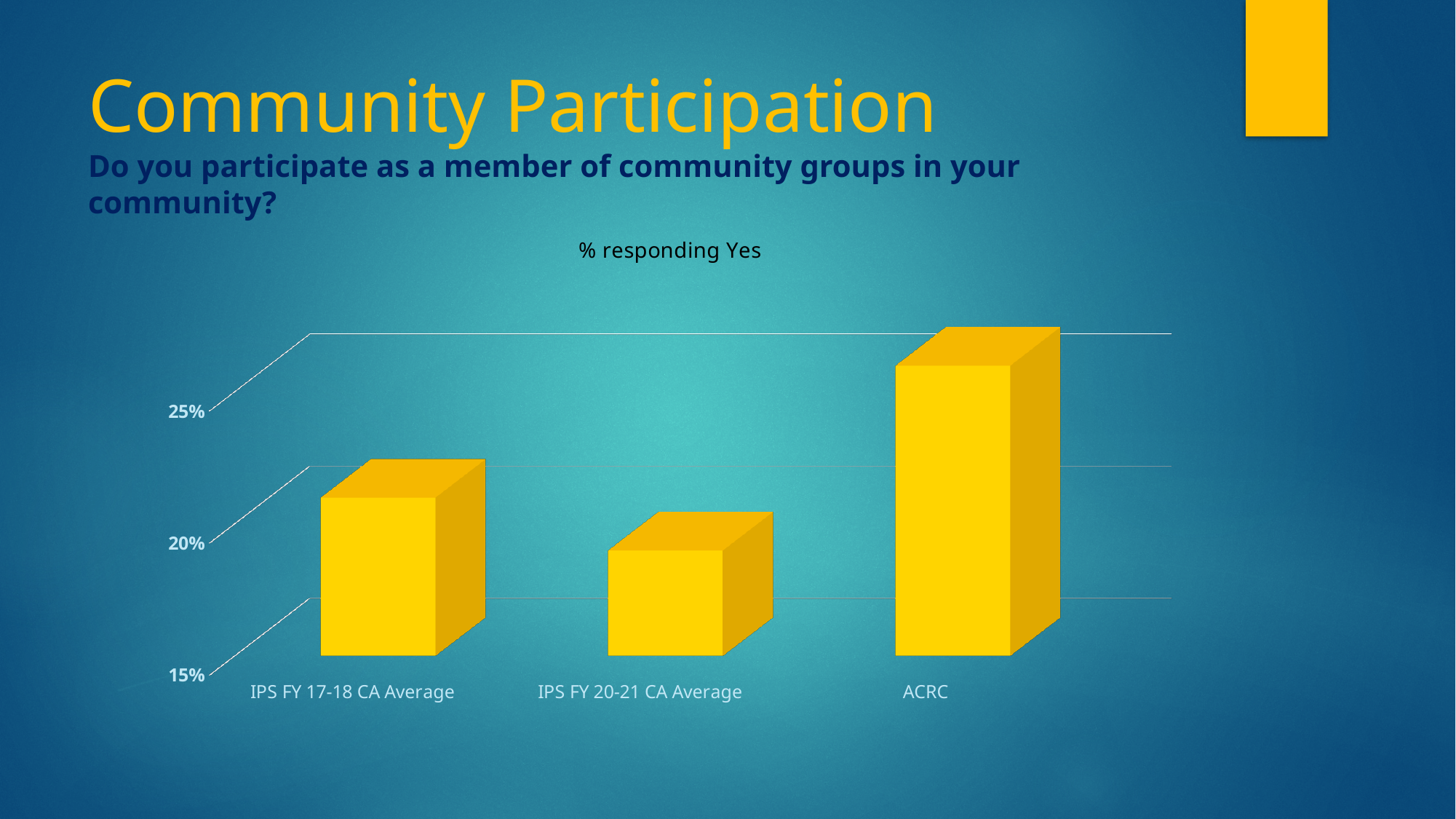
Which is larger, the value for ACRC or the value for IPS FY 17-18 CA Average? ACRC What is the title of the chart? % responding Yes Is the value for IPS FY 20-21 CA Average greater or less than 25%? less What colour are the bars in the chart? Yellow Is the value for ACRC greater or less than 25%? greater Is the value for IPS FY 17-18 CA Average greater or less than 20%? greater Does the value rise or fall from IPS FY 17-18 CA Average to IPS FY 20-21 CA Average? fall Which is larger, the value for IPS FY 17-18 CA Average or the value for IPS FY 20-21 CA Average? IPS FY 17-18 CA Average Which category has the lowest value? IPS FY 20-21 CA Average What type of chart is shown on the slide? Bar chart Which category has the highest value? ACRC How many categories are shown on the chart? 3